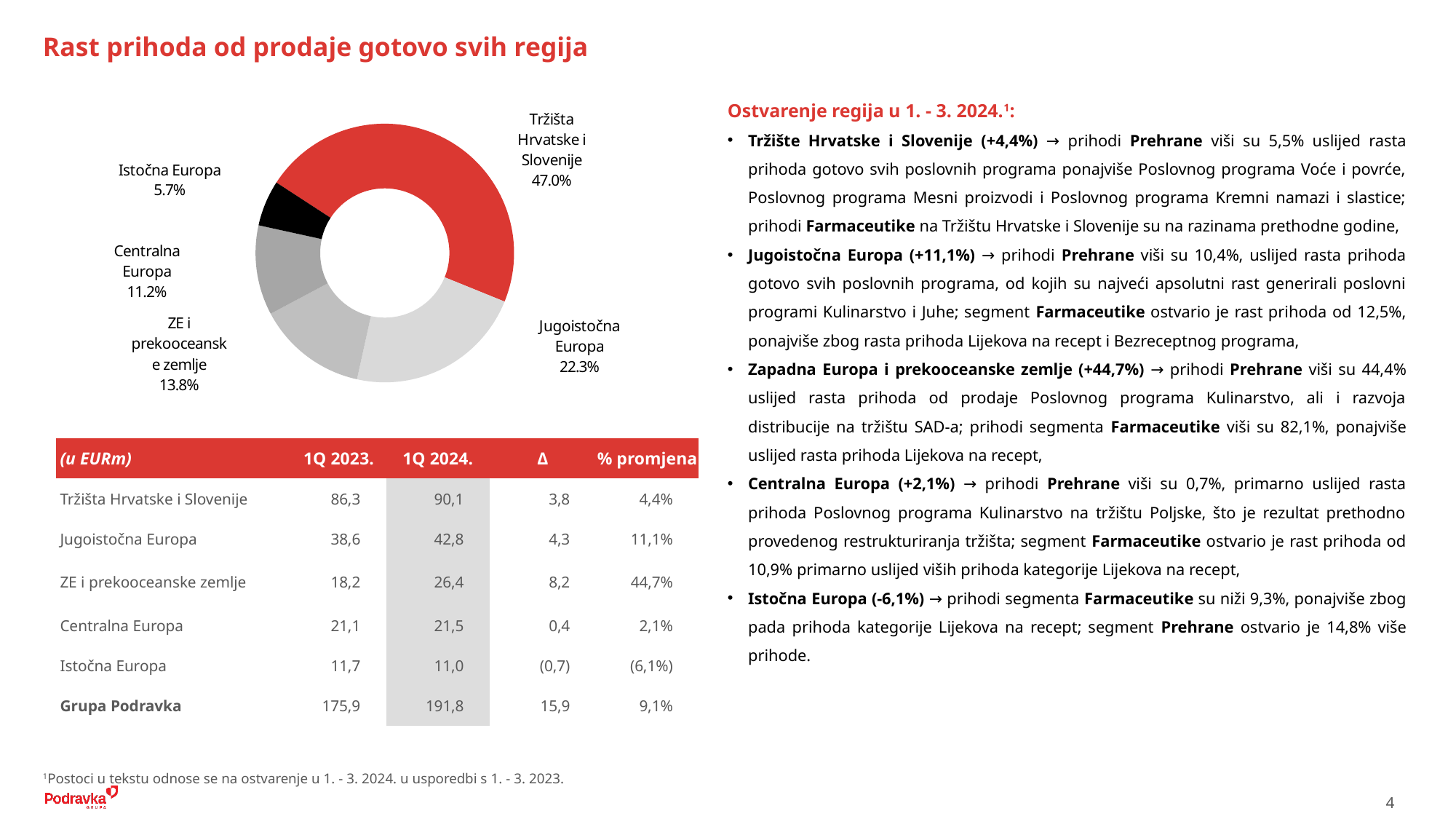
What share of the pie chart does Jugoistočna Europa hold? 22.3% What kind of chart is shown on the slide? Pie chart (donut) Which region has the smallest slice in the pie chart? Istočna Europa What share of the pie chart does Tržišta Hrvatske i Slovenije hold? 47.0% What share of the pie chart does ZE i prekooceanske zemlje hold? 13.8% Which region has the largest slice in the pie chart? Tržišta Hrvatske i Slovenije How many slices does the pie chart have? 5 What colour is the Istočna Europa slice in the pie chart? Black Which slice is larger in the pie chart, Centralna Europa or ZE i prekooceanske zemlje? ZE i prekooceanske zemlje What is the difference in percentage points between the Tržišta Hrvatske i Slovenije slice and the Jugoistočna Europa slice? 24.7 percentage points What share of the pie chart does Centralna Europa hold? 11.2% What share of the pie chart does Istočna Europa hold? 5.7%